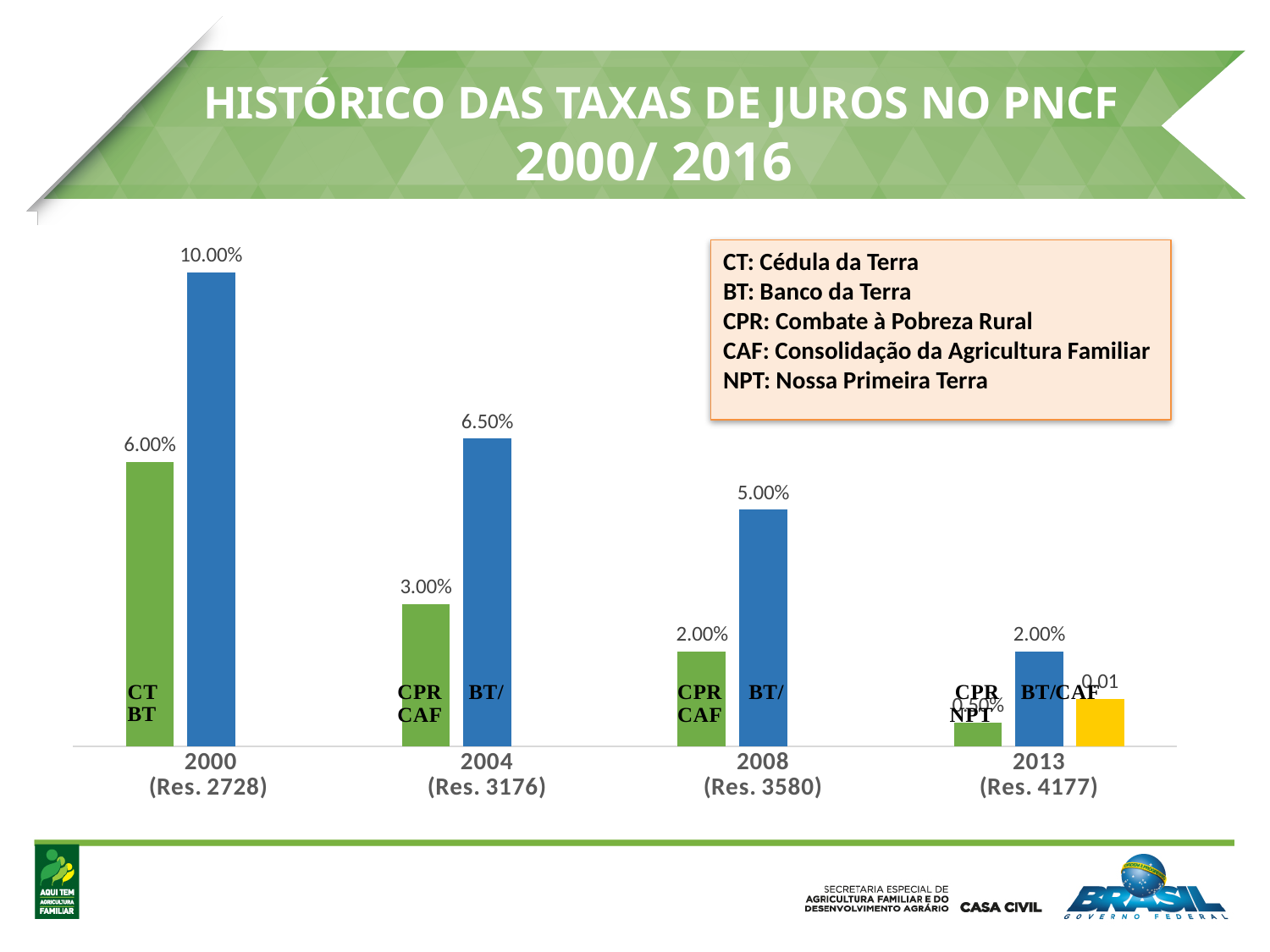
What is the difference between the blue bar and the green bar for 2000 (Res. 2728)? 4.00% What is the value of the green bar for 2008 (Res. 3580)? 2.00% What is the value of the blue bar for 2000 (Res. 2728)? 10.00% Do the blue bars rise or fall from 2000 to 2013? Fall What kind of chart is shown on the slide? Bar chart What is the difference between the blue bar and the green bar for 2004 (Res. 3176)? 3.50% Which is larger: the green bar for 2004 (Res. 3176) or the blue bar for 2008 (Res. 3580)? The blue bar for 2008 (Res. 3580) Which year has the highest bar on the chart? 2000 (Res. 2728) How many year categories are shown on the x axis? 4 What is the value of the blue bar for 2004 (Res. 3176)? 6.50% What is the value of the blue bar for 2013 (Res. 4177)? 2.00% What is the value of the green bar for 2000 (Res. 2728)? 6.00%